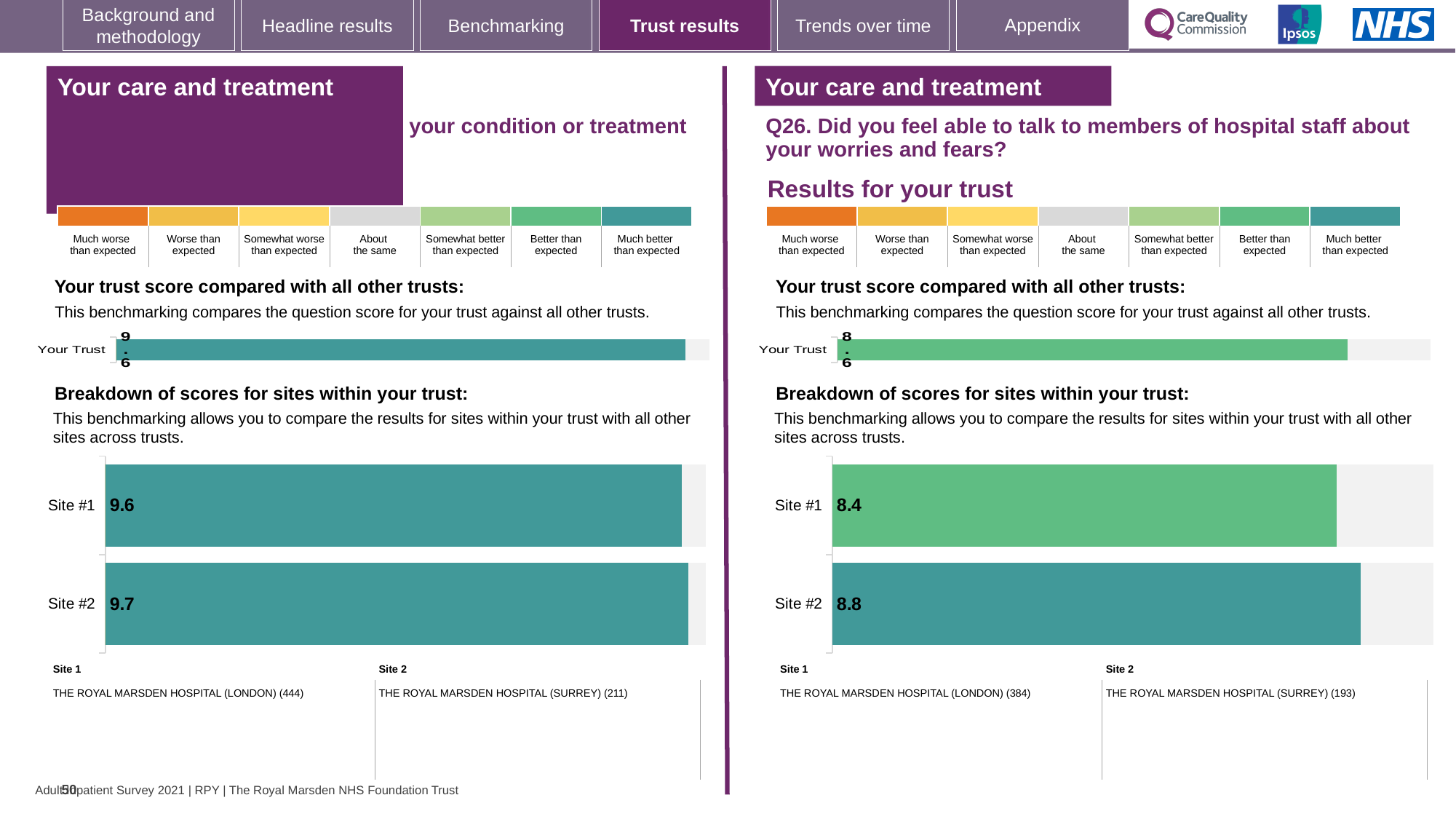
On the right-hand panel (Q26), which site is listed as Site 1 below the breakdown chart? THE ROYAL MARSDEN HOSPITAL (LONDON) (384) On the left-hand panel, what is the score for Your Trust in the 'Your trust score compared with all other trusts' chart? 9.6 On the left-hand panel, what is the score for Site #2 in the breakdown of scores for sites chart? 9.7 On the right-hand panel (Q26), what is the score for Site #1 in the breakdown of scores for sites chart? 8.4 On the left-hand panel, what is the score for Site #1 in the breakdown of scores for sites chart? 9.6 On the left-hand panel, what is the difference between the Site #2 and Site #1 scores in the breakdown chart? 0.1 How many sites are shown in the breakdown of scores for sites chart on the right-hand panel (Q26)? 2 What type of chart is used for the breakdown of scores for sites on the left-hand panel? Bar chart On the right-hand panel (Q26), what is the score for Site #2 in the breakdown of scores for sites chart? 8.8 On the right-hand panel (Q26), what is the difference between the Site #2 and Site #1 scores in the breakdown chart? 0.4 On the right-hand panel (Q26), which site has the higher score in the breakdown of scores for sites chart? Site #2 On the right-hand panel (Q26), what is the score for Your Trust in the 'Your trust score compared with all other trusts' chart? 8.6